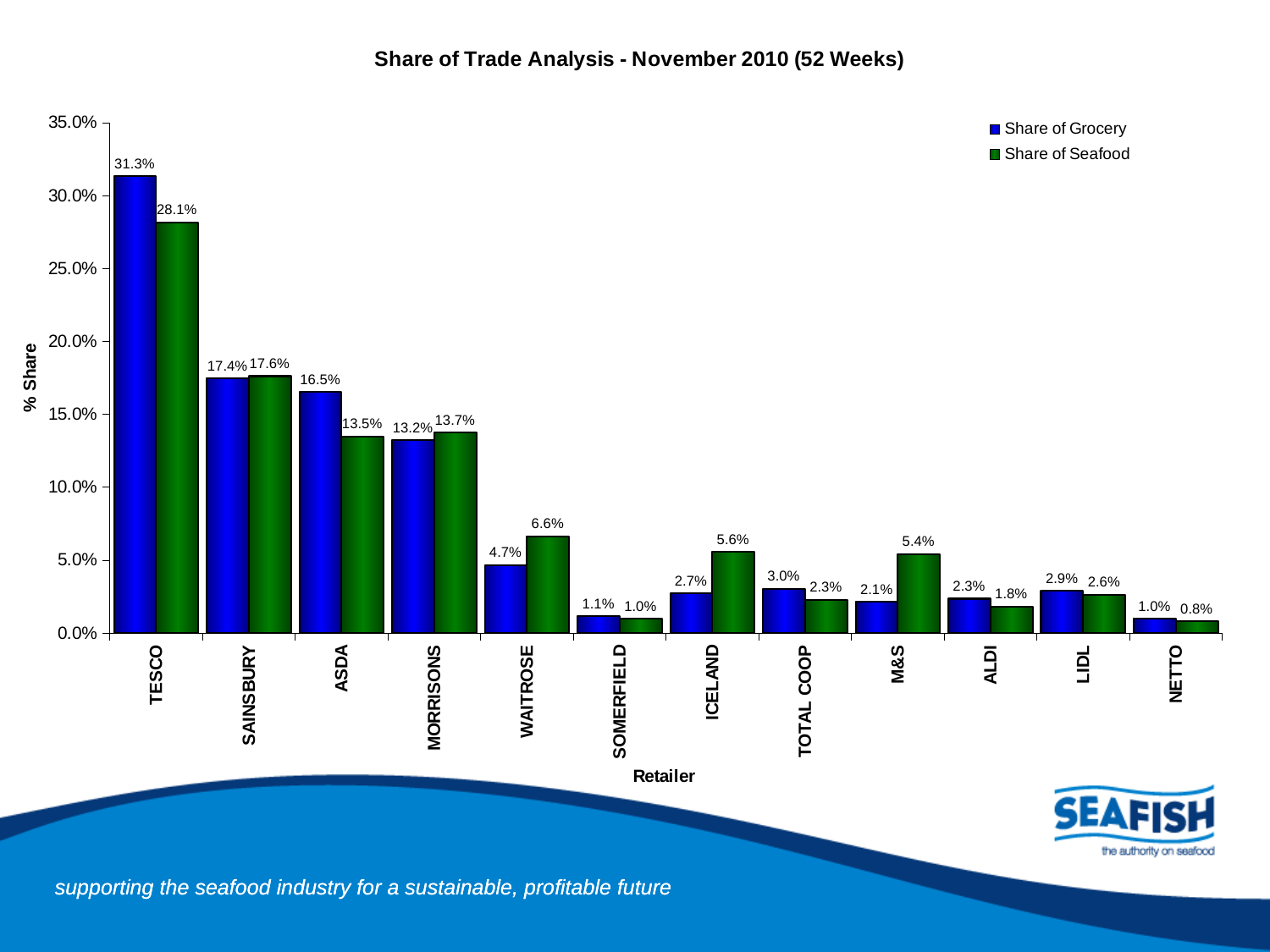
How many series does the legend list? 2 What is the difference between TESCO's Share of Grocery and Share of Seafood? 3.2% How many retailers are shown on the x axis? 12 Which retailer has the lowest Share of Seafood? NETTO What is the Share of Grocery value for TESCO? 31.3% What kind of chart is shown on the slide? Bar chart What is the Share of Seafood value for ASDA? 13.5% Which is larger for TOTAL COOP: Share of Grocery or Share of Seafood? Share of Grocery What is the title of the chart? Share of Trade Analysis - November 2010 (52 Weeks) What is the Share of Seafood value for M&S? 5.4% Which is larger for WAITROSE: Share of Grocery or Share of Seafood? Share of Seafood Which retailer has the highest Share of Seafood? TESCO